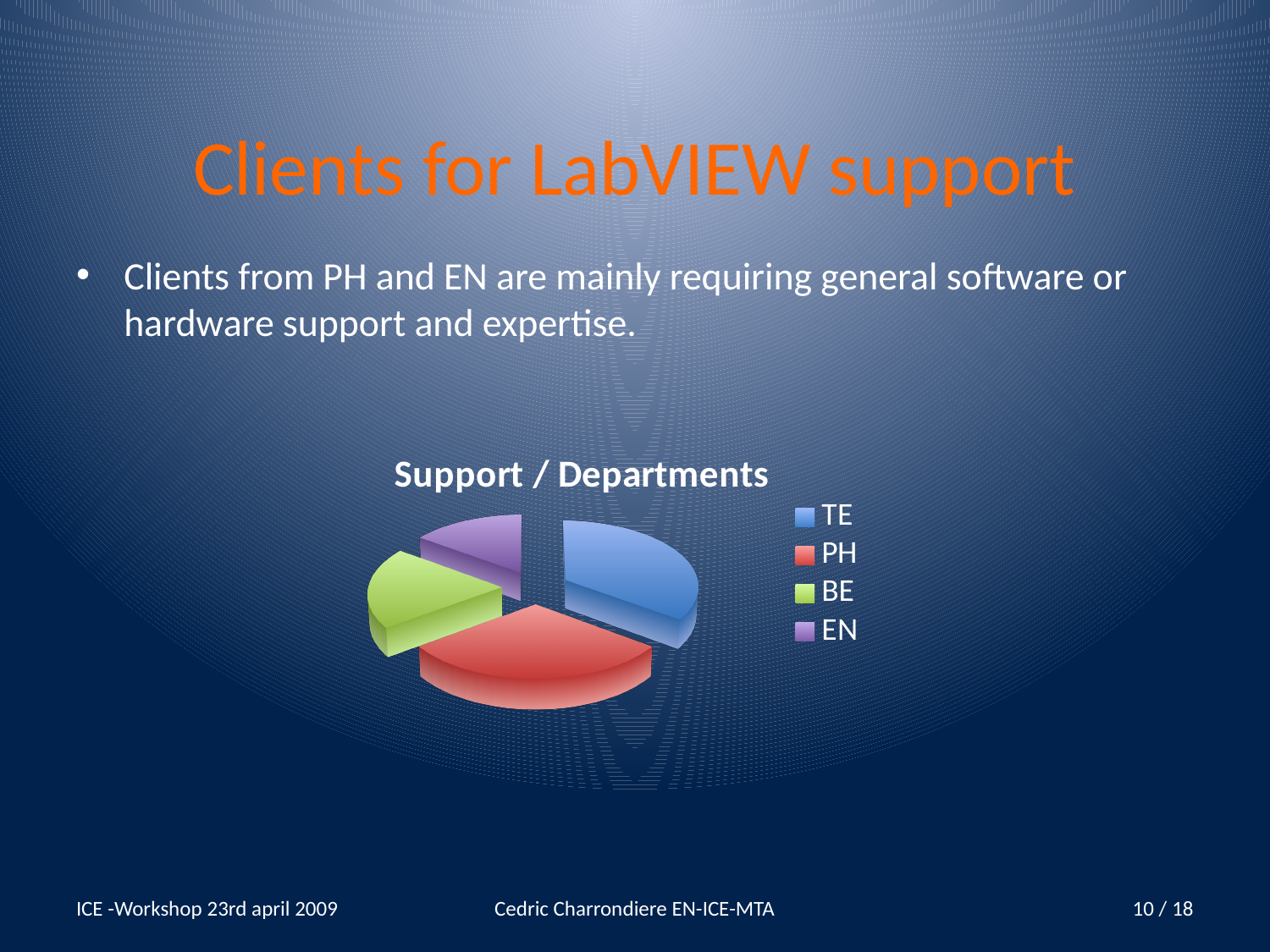
Which slice is larger, TE or EN? TE How many entries does the chart legend list? 4 Which slice is larger, PH or EN? PH What kind of chart is shown on the slide? pie chart How many categories does the pie chart show? 4 Which department has the smallest slice of the pie? EN Which colour represents the BE department in the pie chart? green What is the title of the chart? Support / Departments Which slice is larger, BE or EN? BE